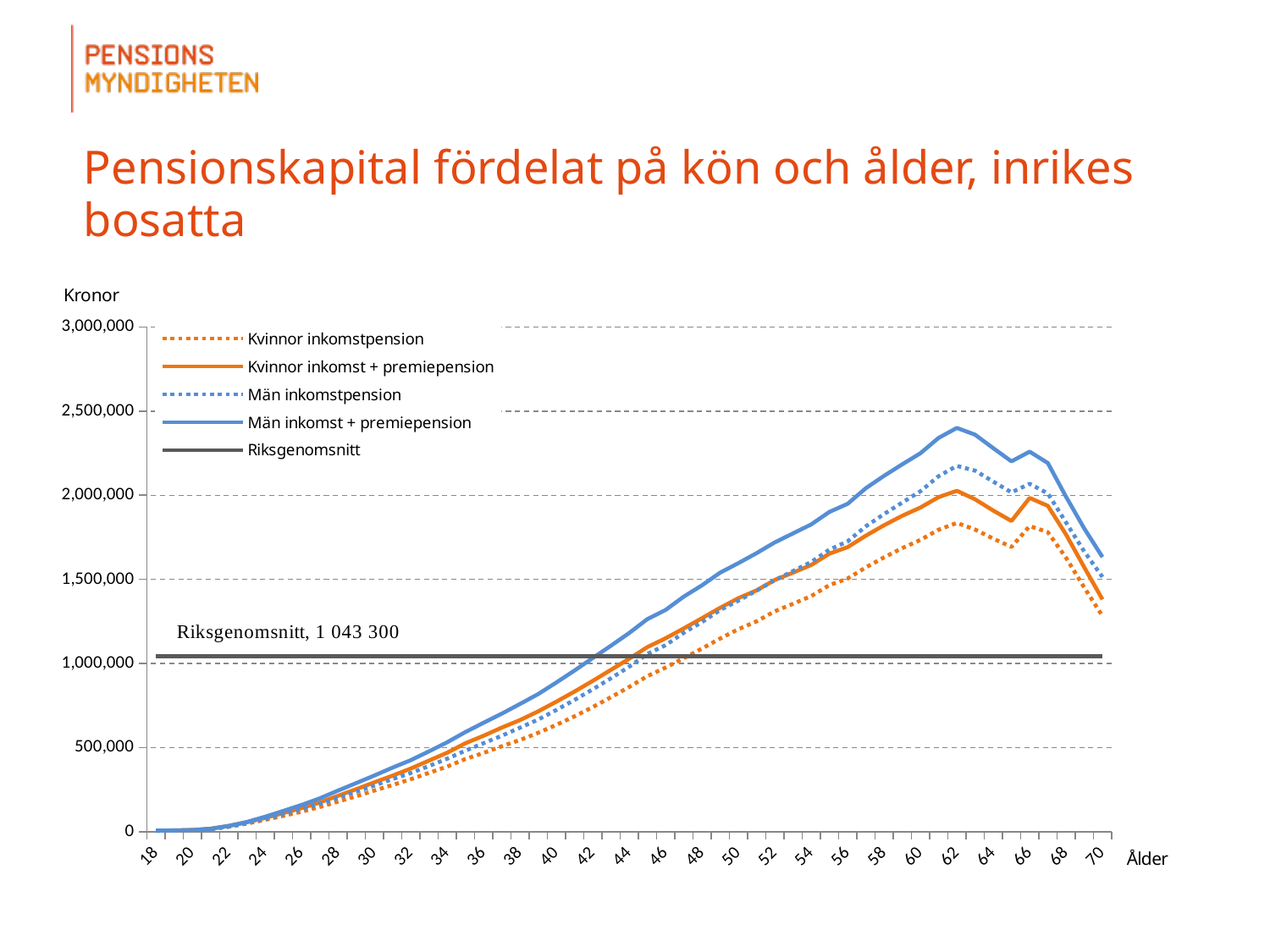
Which series has the lowest value at age 62? Kvinnor inkomstpension What is the title of the chart on the slide? Pensionskapital fördelat på kön och ålder, inrikes bosatta At age 62, which is larger: Män inkomst + premiepension or Kvinnor inkomstpension? Män inkomst + premiepension Is the value for Kvinnor inkomstpension at age 62 greater or less than 2,000,000? less Is the value for Kvinnor inkomstpension at age 70 greater or less than 1,500,000? less What kind of chart is shown on the slide? line chart Is the value for Män inkomst + premiepension at age 62 greater or less than 2,000,000? greater Which series has the highest value at age 62? Män inkomst + premiepension What is the value of Riksgenomsnitt shown on the chart? 1 043 300 How many series does the legend list? 5 Do the values for Män inkomst + premiepension rise or fall from age 18 to age 62? rise